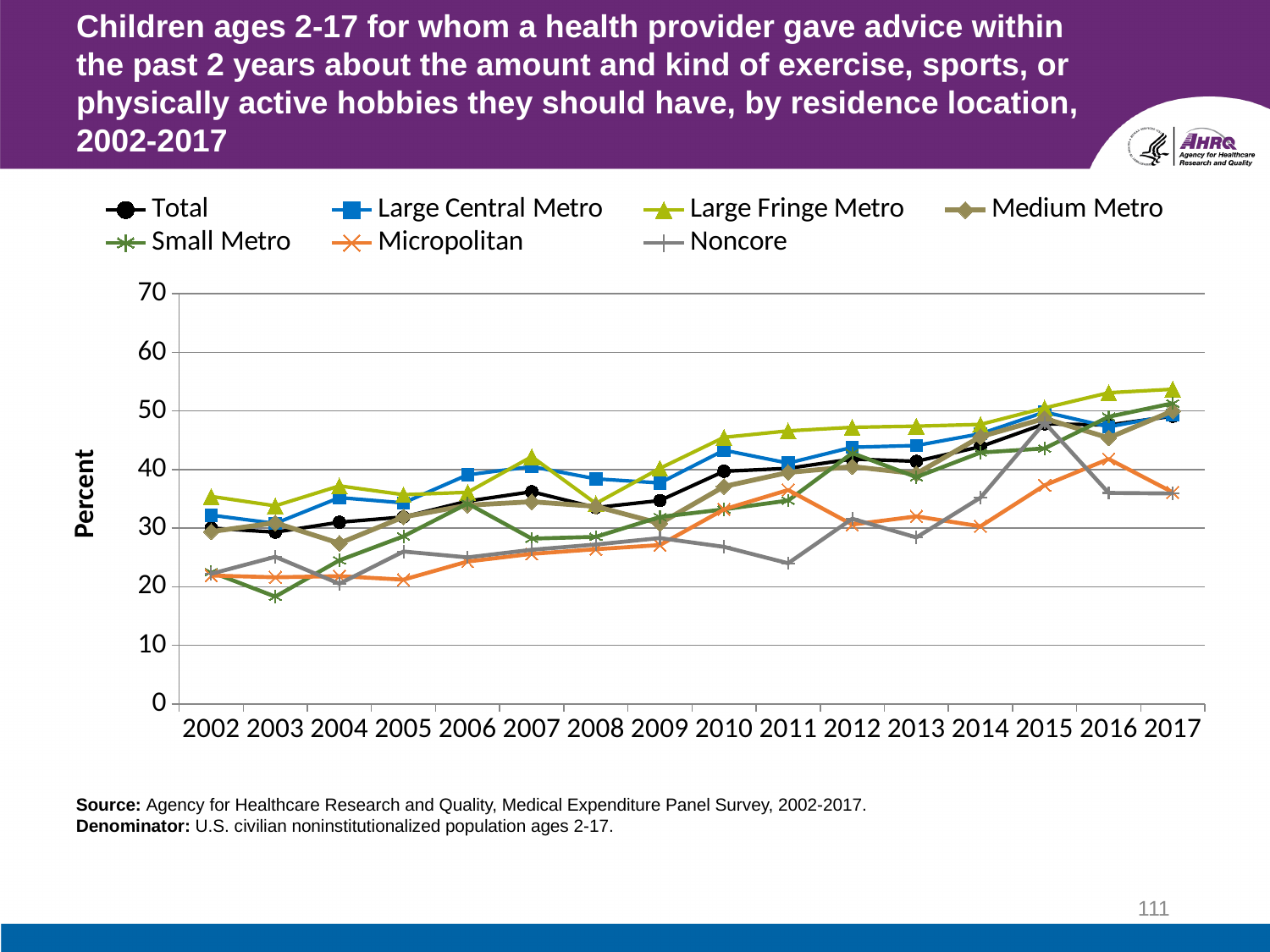
In 2011, which is larger: Large Fringe Metro or Noncore? Large Fringe Metro Is the value for Micropolitan in 2005 greater or less than 30? less Is the value for Total in 2015 greater or less than 40? greater What is the label on the y axis? Percent Which series has the lowest value in 2003? Small Metro What kind of chart is shown on the slide? line chart How many years are plotted along the x axis? 16 How many series does the legend list? 7 Which series has the highest value in 2017? Large Fringe Metro Is the value for Large Fringe Metro in 2017 greater or less than 50? greater Does the Total series generally rise or fall from 2002 to 2017? rise